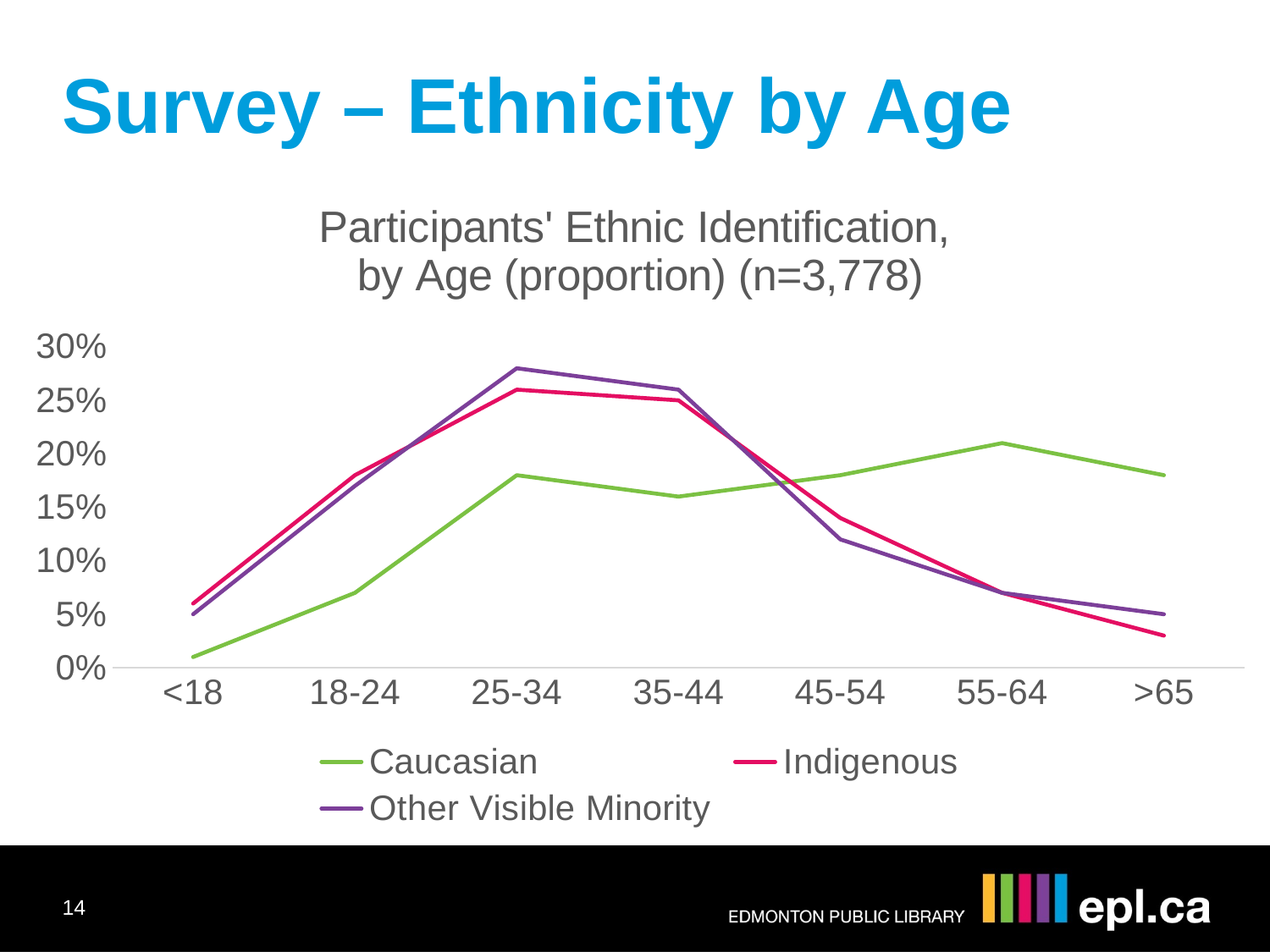
For which age group is the Indigenous line at its lowest? >65 What kind of chart is shown on the slide? line chart How many age categories are shown on the x axis? 7 Is the Indigenous value for >65 greater or less than 5%? less For which age group is the Indigenous line at its highest? 25-34 Does the Indigenous line rise or fall from 35-44 to >65? fall What is the title of the chart? Participants' Ethnic Identification, by Age (proportion) (n=3,778) For which age group is the Caucasian line at its lowest? <18 How many series does the legend list? 3 For which age group is the Caucasian line at its highest? 55-64 At 25-34, which is larger: the Caucasian value or the Other Visible Minority value? Other Visible Minority Is the Other Visible Minority value for 25-34 greater or less than 25%? greater